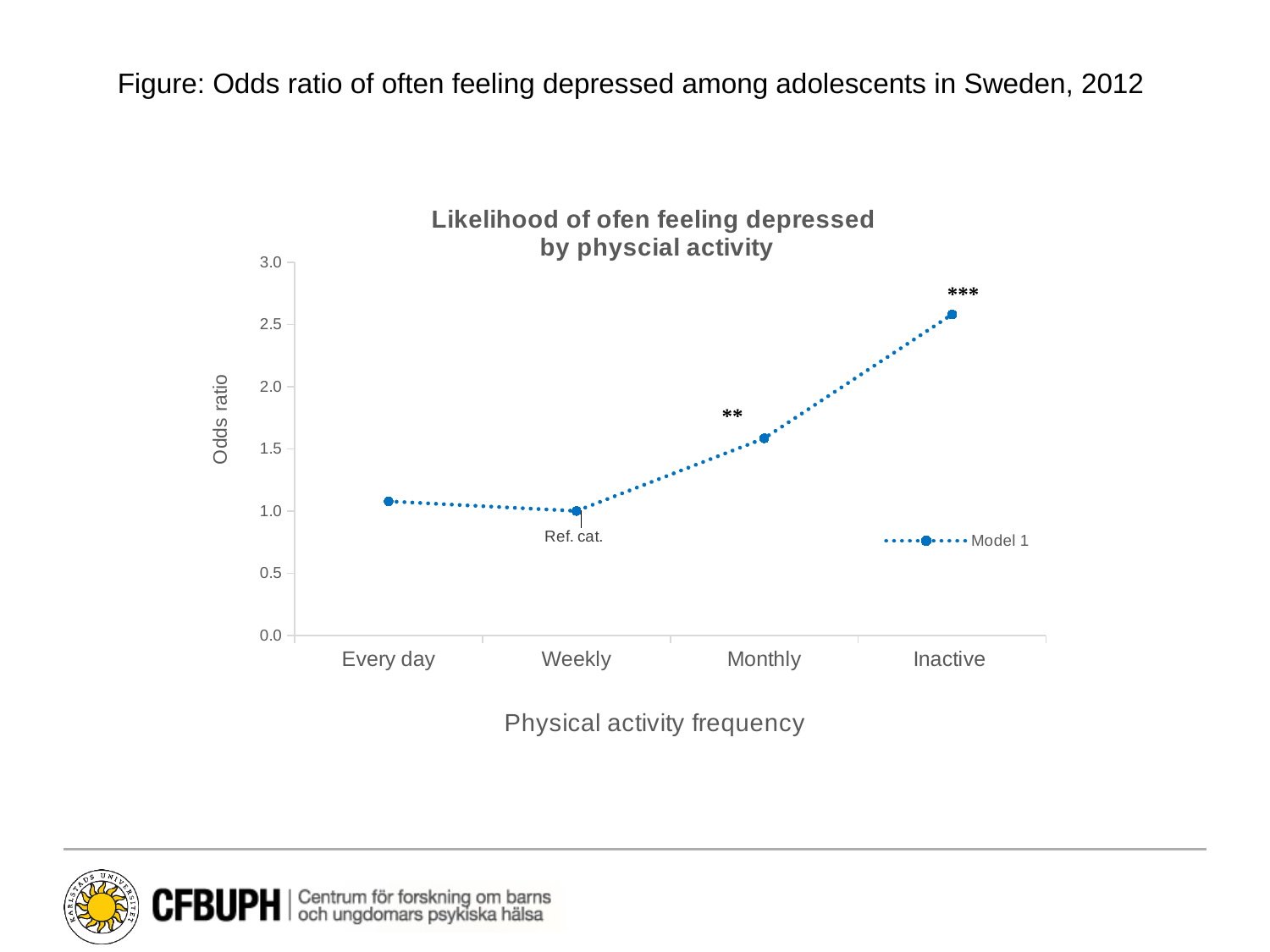
Which has a higher odds ratio, Every day or Monthly? Monthly How many series does the legend list? 1 What type of chart is shown on the slide? Line chart Which has a higher odds ratio, Monthly or Inactive? Inactive Is the odds ratio for Inactive greater or less than 2.0? greater What is the name of the series shown in the legend? Model 1 How many physical activity categories are plotted on the x axis? 4 What is the odds ratio for the Weekly category, marked as the reference category? 1.0 Is the odds ratio for Monthly greater or less than 2.0? less Which physical activity category has the highest odds ratio? Inactive Is the odds ratio for Every day greater or less than 1.5? less Does the odds ratio rise or fall from Weekly to Inactive along the x axis? Rises